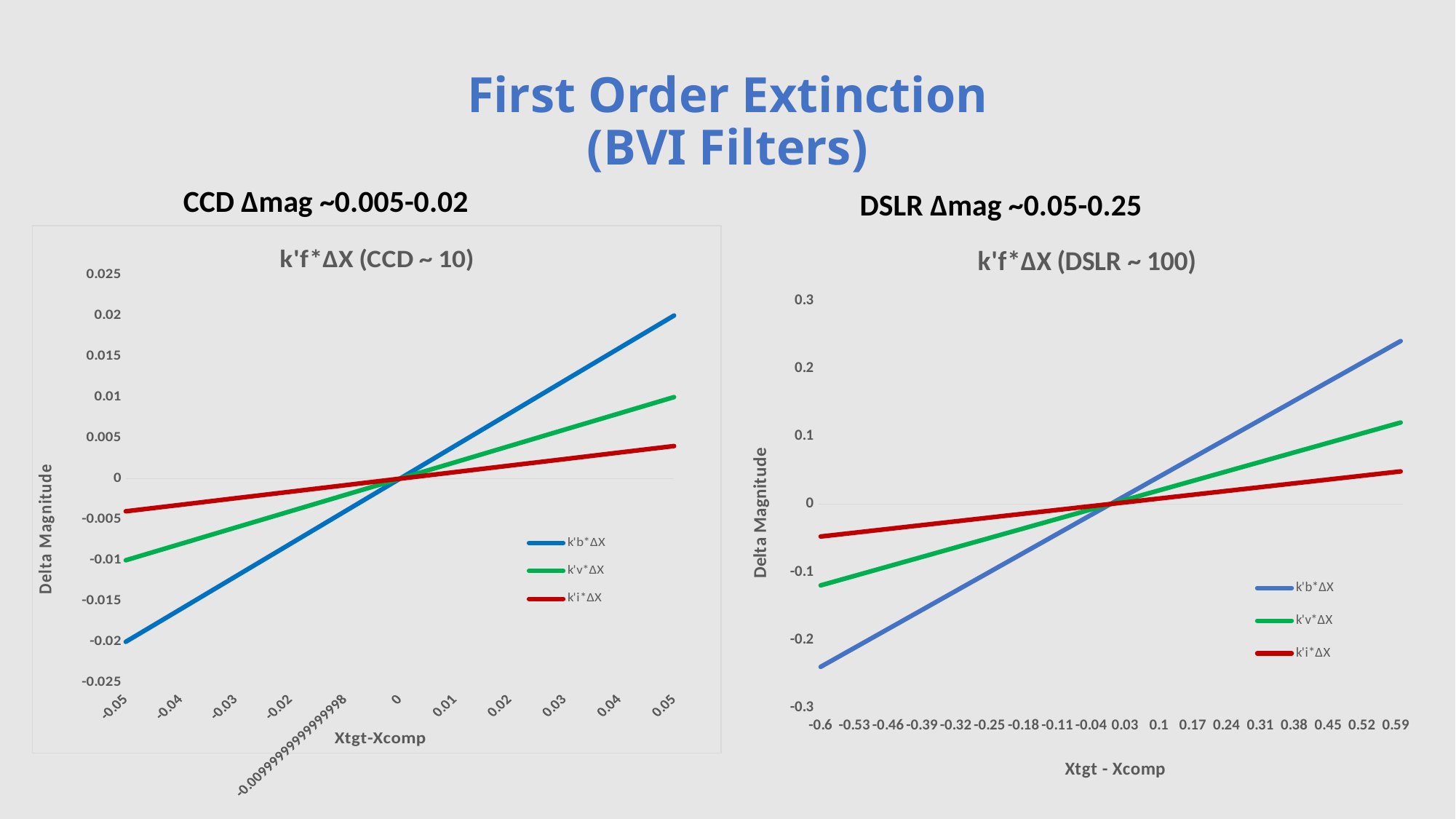
In the left chart (CCD ~ 10), what is the value of k'b*ΔX at Xtgt-Xcomp = 0.05? 0.02 In the left chart (CCD ~ 10), which series has the highest value at Xtgt-Xcomp = 0.05? k'b*ΔX How many series does the legend of the right chart titled "k'f*ΔX (DSLR ~ 100)" list? 3 In the right chart (DSLR ~ 100), which series has the lowest value at the right end of the x axis? k'i*ΔX In the right chart (DSLR ~ 100), which is larger at the right end of the x axis: k'v*ΔX or k'i*ΔX? k'v*ΔX In the left chart (CCD ~ 10), what is the value of k'b*ΔX at Xtgt-Xcomp = -0.05? -0.02 In the left chart (CCD ~ 10), what is the value of k'v*ΔX at Xtgt-Xcomp = 0.05? 0.01 In the right chart (DSLR ~ 100), is the value of k'i*ΔX at Xtgt - Xcomp = -0.6 greater or less than -0.1? greater In the right chart (DSLR ~ 100), is the value of k'b*ΔX at Xtgt - Xcomp = 0.59 greater or less than 0.2? greater What kind of chart is the left chart titled "k'f*ΔX (CCD ~ 10)"? line chart In the left chart (CCD ~ 10), does the k'b*ΔX line rise or fall as Xtgt-Xcomp increases? rise What is the y-axis label of the right chart titled "k'f*ΔX (DSLR ~ 100)"? Delta Magnitude